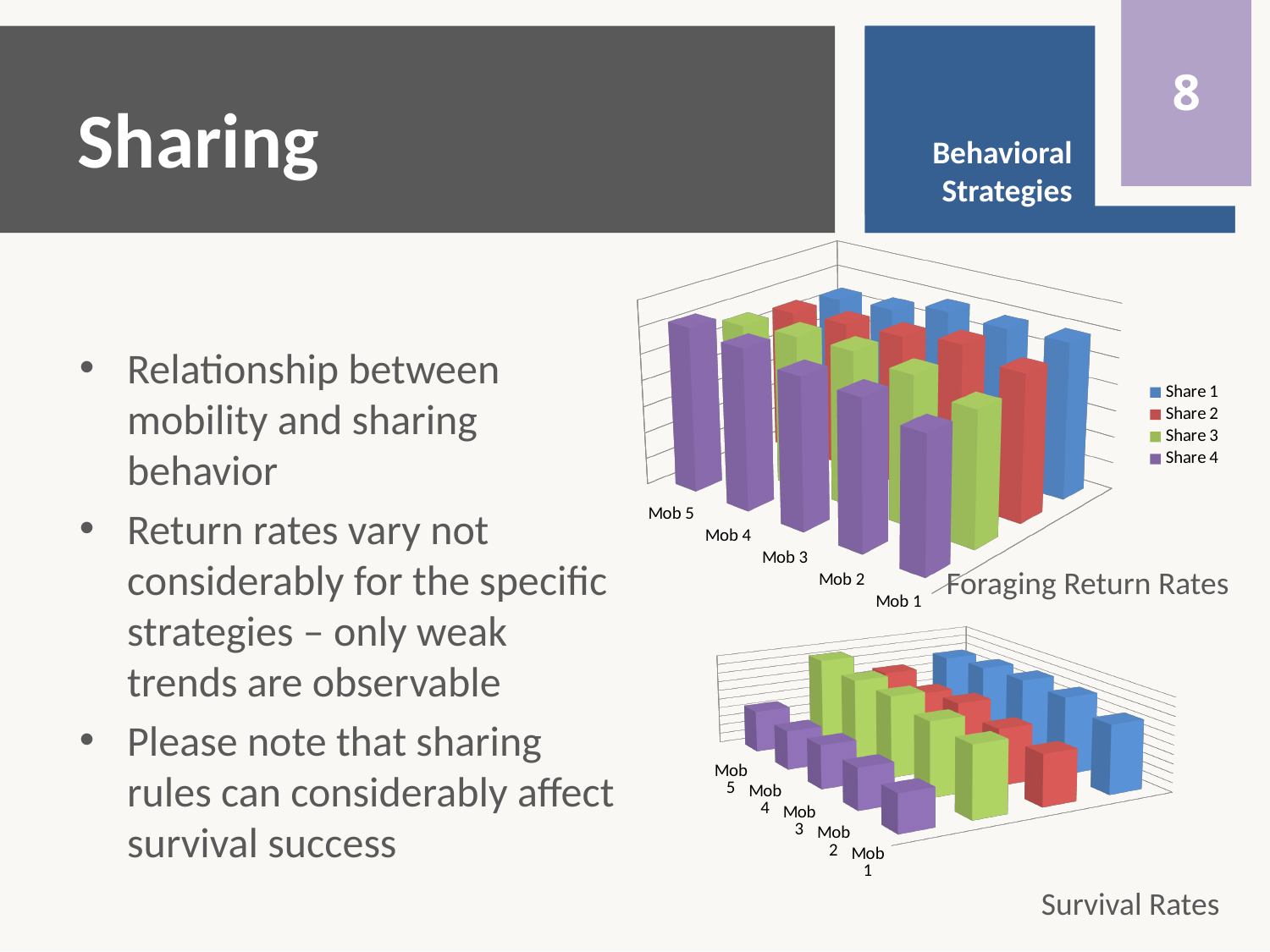
How many Mob categories are shown on the Survival Rates chart? 5 What is the title of the top chart on the slide? Foraging Return Rates How many Mob categories are shown on the Foraging Return Rates chart? 5 What is the title of the bottom chart on the slide? Survival Rates In the Survival Rates chart, is the Share 4 bar for Mob 1 larger or smaller than the Share 3 bar for Mob 1? smaller What kind of chart is the Survival Rates chart? bar chart What kind of chart is the Foraging Return Rates chart? bar chart How many series does the legend of the Foraging Return Rates chart list? 4